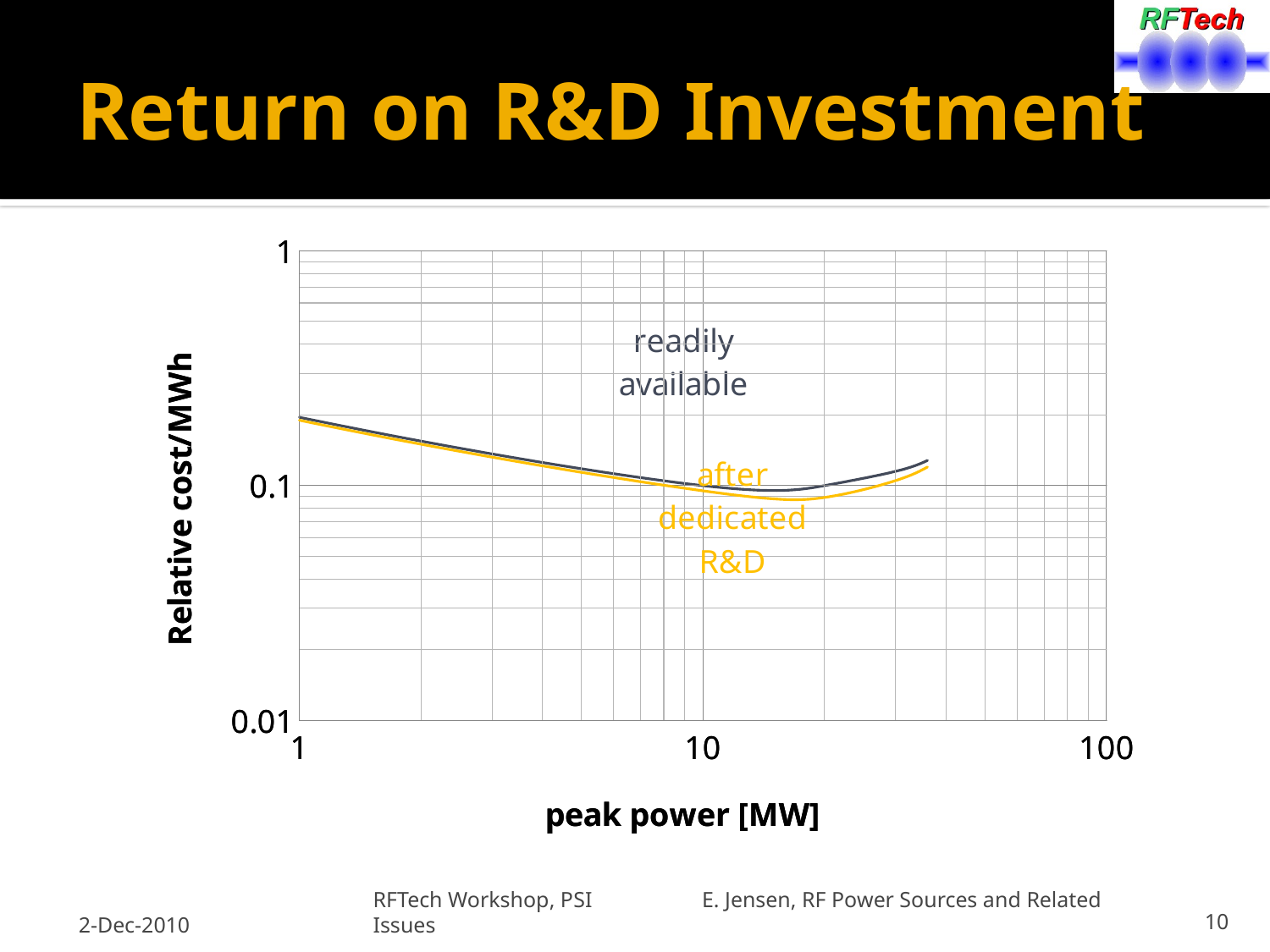
What kind of chart is shown on the slide? line chart Which curve lies lower on the chart, 'readily available' or 'after dedicated R&D'? after dedicated R&D What is the lowest value labelled on the y axis of the chart? 0.01 Is the relative cost/MWh of the 'readily available' curve at 1 MW greater or less than 1? less How many curves (series) are plotted on the chart? 2 Is the relative cost/MWh of the 'readily available' curve at 1 MW greater or less than 0.1? greater What is the title of the y axis of the chart? Relative cost/MWh What is the highest value labelled on the x axis of the chart? 100 Is the relative cost/MWh of the 'after dedicated R&D' curve at 10 MW greater or less than 0.01? greater Does the 'readily available' curve rise or fall as peak power increases from 1 MW to 10 MW? fall What is the title of the x axis of the chart? peak power [MW] Which curve is drawn in yellow, 'readily available' or 'after dedicated R&D'? after dedicated R&D